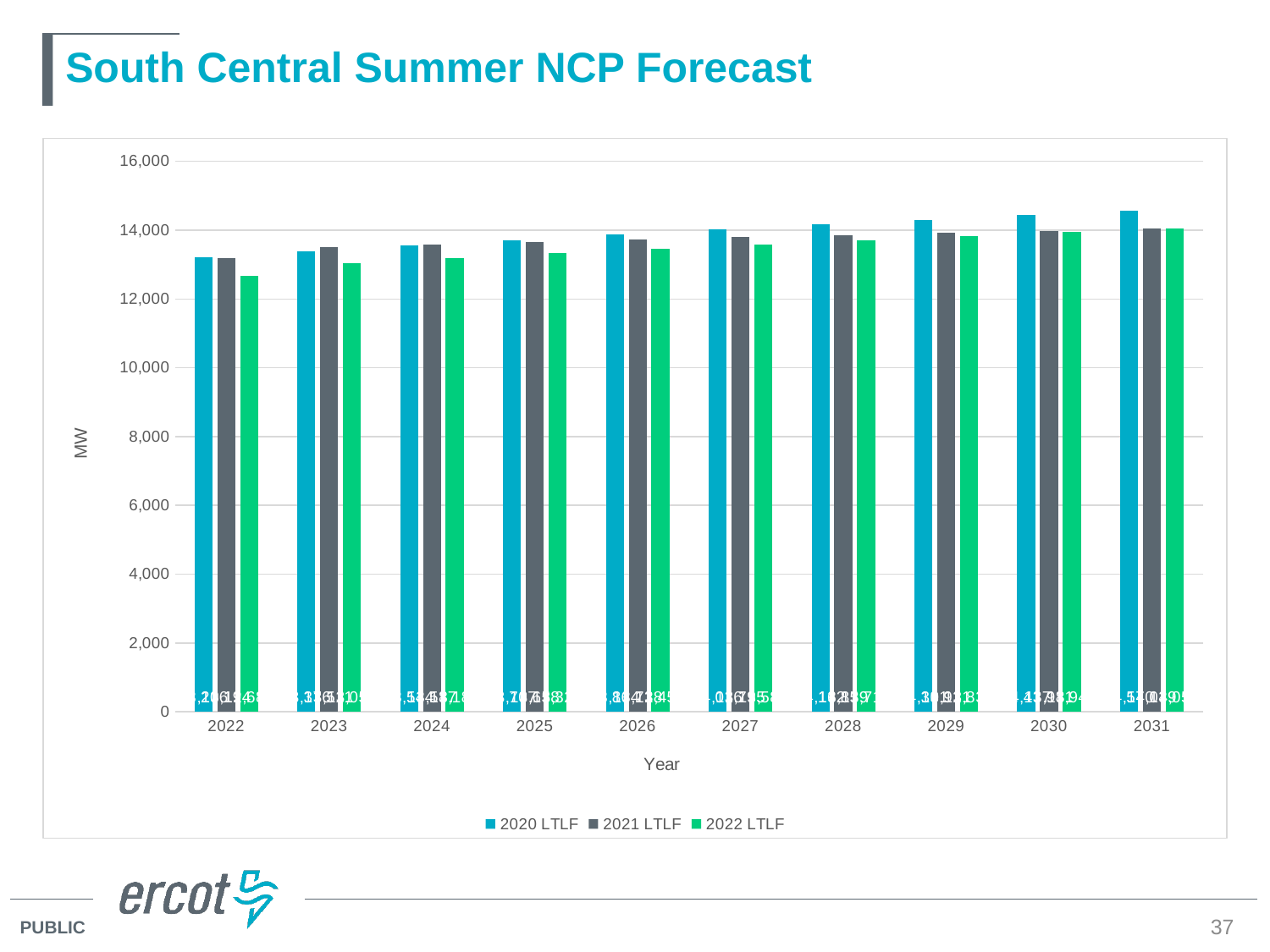
Is the 2020 LTLF value for 2031 greater or less than 14,000? greater How many years are shown along the x axis? 10 Is the 2022 LTLF value for 2022 greater or less than 12,000? greater What type of chart is shown on the slide? Bar chart Which year has the lowest 2022 LTLF value? 2022 How many series does the legend list? 3 What unit is shown on the y axis label? MW Is the 2022 LTLF value for 2022 greater or less than 14,000? less Which year has the highest 2020 LTLF value? 2031 Do the 2020 LTLF values rise or fall from 2022 to 2031? Rise In 2031, which is larger: the 2020 LTLF value or the 2022 LTLF value? 2020 LTLF In 2022, which is larger: the 2020 LTLF value or the 2022 LTLF value? 2020 LTLF